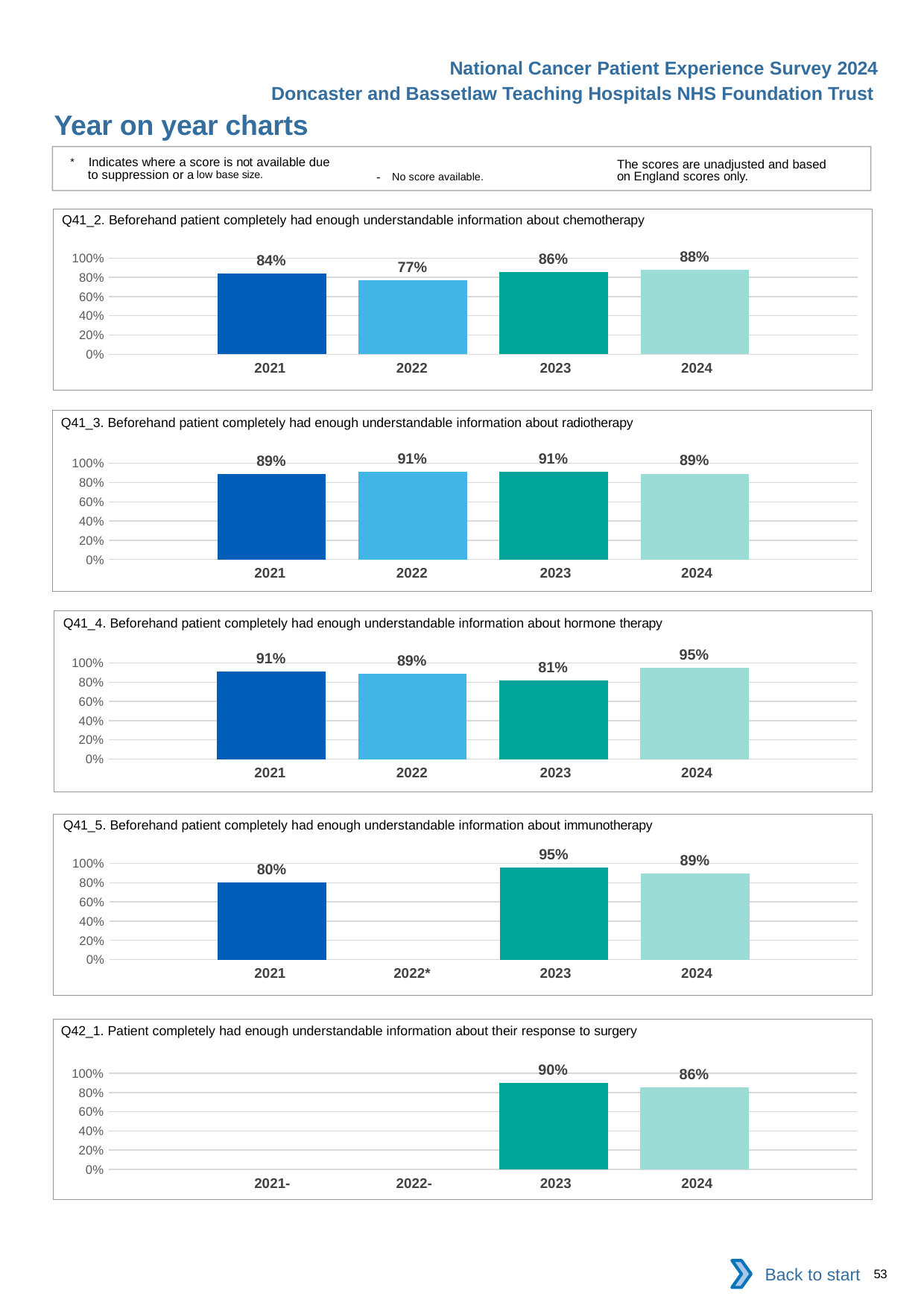
In the Q41_3 chart (radiotherapy), what is the value for 2023? 91% In the Q41_4 chart (hormone therapy), which is larger, the value for 2021 or the value for 2022? 2021 In the Q41_4 chart (hormone therapy), what is the difference between the 2024 and 2023 values? 14% In the Q41_5 chart (immunotherapy), what is the value for 2023? 95% In the Q42_1 chart (response to surgery), what is the value for 2024? 86% In the Q41_3 chart (radiotherapy), how many bars are plotted? 4 In the Q41_2 chart (chemotherapy), what is the difference between the 2024 and 2021 values? 4% What type of chart is the Q42_1 chart (response to surgery)? Bar chart In the Q41_4 chart (hormone therapy), which year has the lowest value? 2023 In the Q41_2 chart (chemotherapy), what is the value for 2022? 77% In the Q41_2 chart (chemotherapy), which year has the highest value? 2024 In the Q41_5 chart (immunotherapy), which year has no bar shown because the score is not available? 2022*